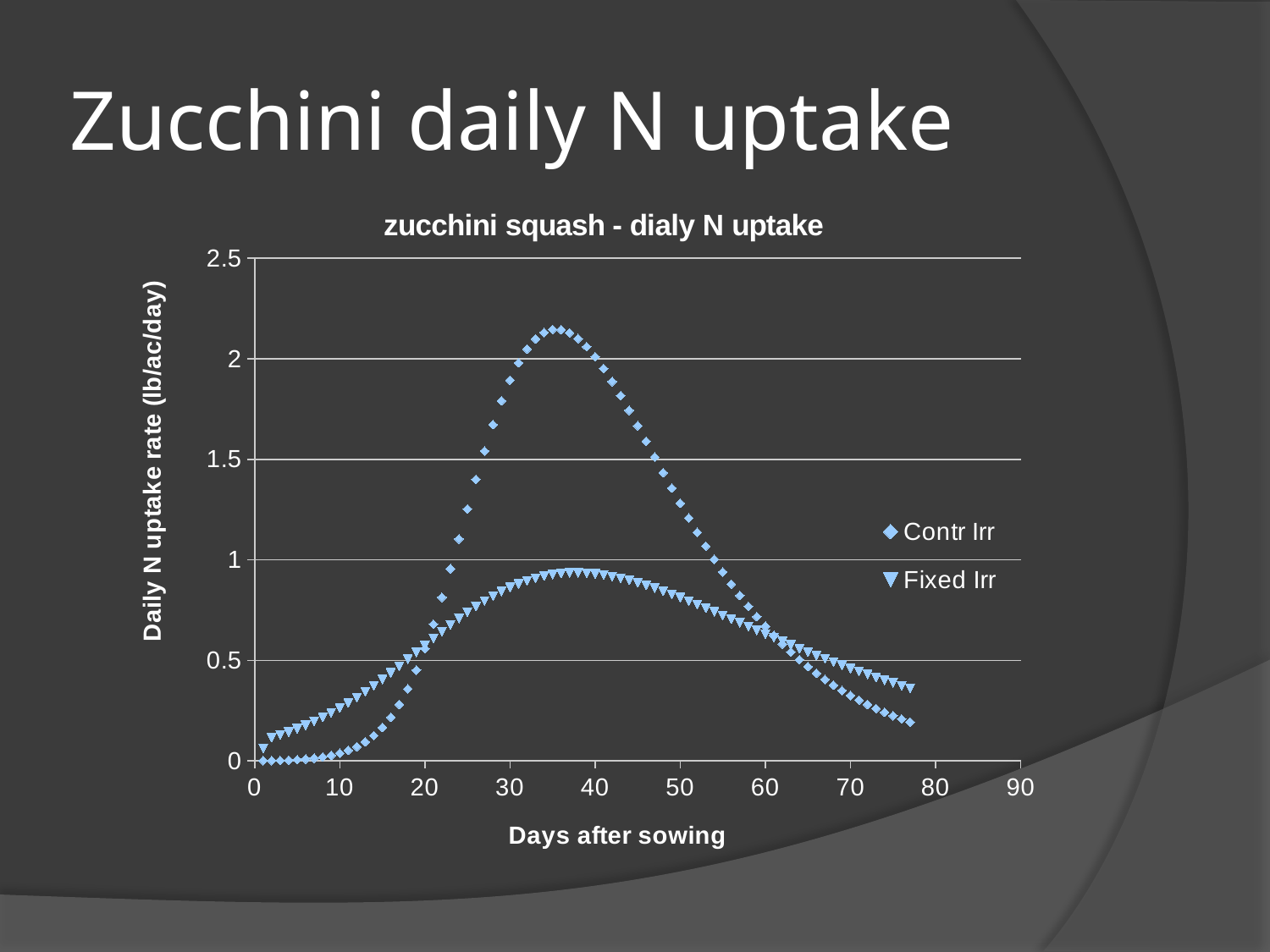
How many series does the legend list? 2 Is the Contr Irr value at around 50 days after sowing greater or less than 1.5? less Is the Fixed Irr value at around 20 days after sowing greater or less than 0.5? greater At around 35 days after sowing, which series has the higher value, Contr Irr or Fixed Irr? Contr Irr Which series reaches the higher peak daily N uptake rate, Contr Irr or Fixed Irr? Contr Irr What kind of chart is shown on the slide? Scatter chart What are the two series named in the legend? Contr Irr and Fixed Irr Does the Contr Irr series rise and then fall, or rise steadily, as days after sowing increase? Rises and then falls Is the peak value of the Fixed Irr series greater or less than 1? less At around 10 days after sowing, which series has the higher value, Contr Irr or Fixed Irr? Fixed Irr What is the title of the chart? zucchini squash - dialy N uptake